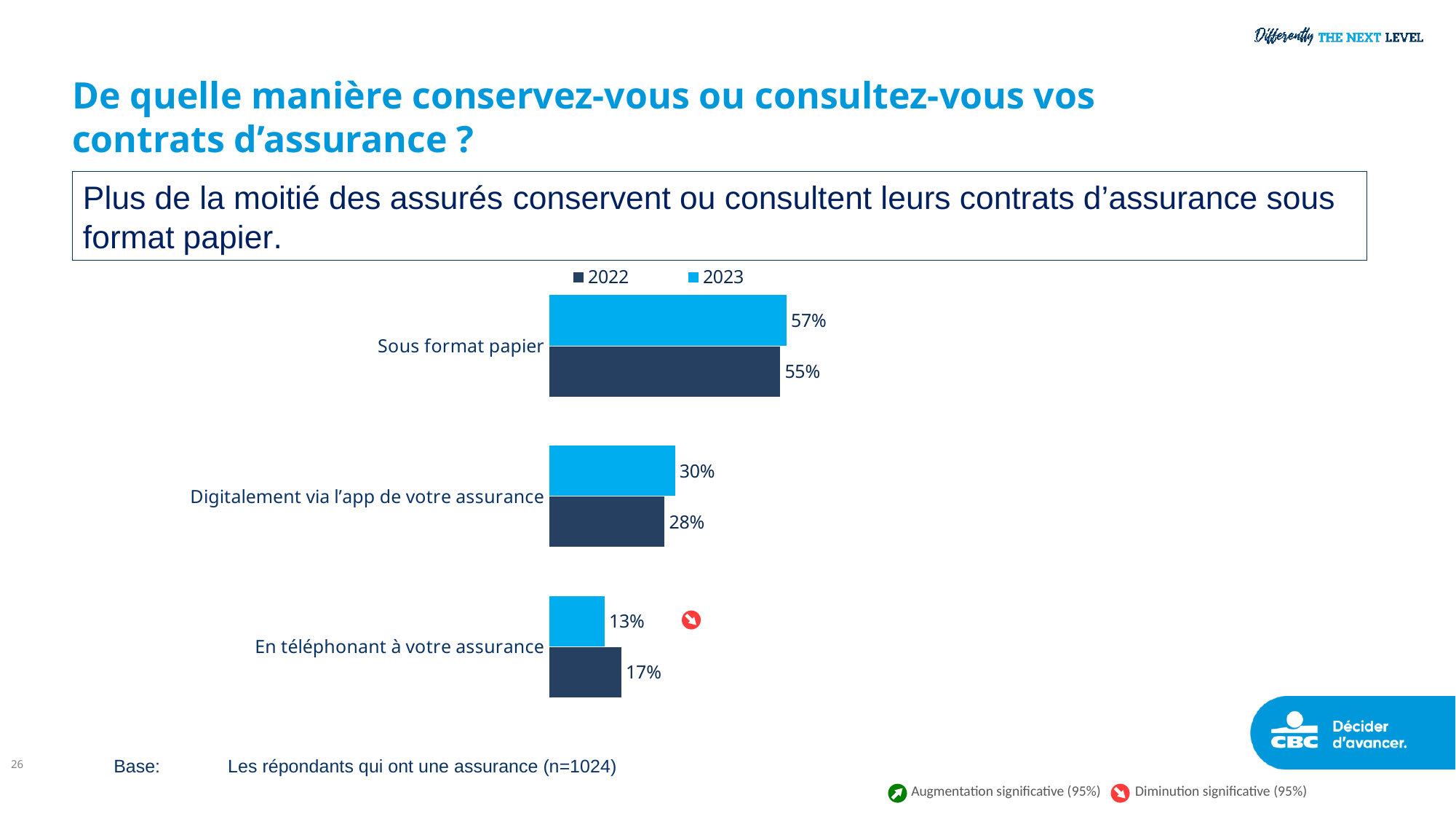
For "Digitalement via l'app de votre assurance", which year has the larger value, 2022 or 2023? 2023 How many categories are shown in the chart? 3 What kind of chart is shown on the slide? Bar chart Which category has the highest 2023 value? Sous format papier What is the 2022 value for "En téléphonant à votre assurance"? 17% What is the 2023 value for "Sous format papier"? 57% What is the 2022 value for "Sous format papier"? 55% Which category has the lowest 2022 value? En téléphonant à votre assurance What is the difference between the 2022 and 2023 values for "En téléphonant à votre assurance"? 4% What is the 2023 value for "Digitalement via l'app de votre assurance"? 30% Which category is marked with a significant decrease indicator? En téléphonant à votre assurance How many series does the legend list? 2